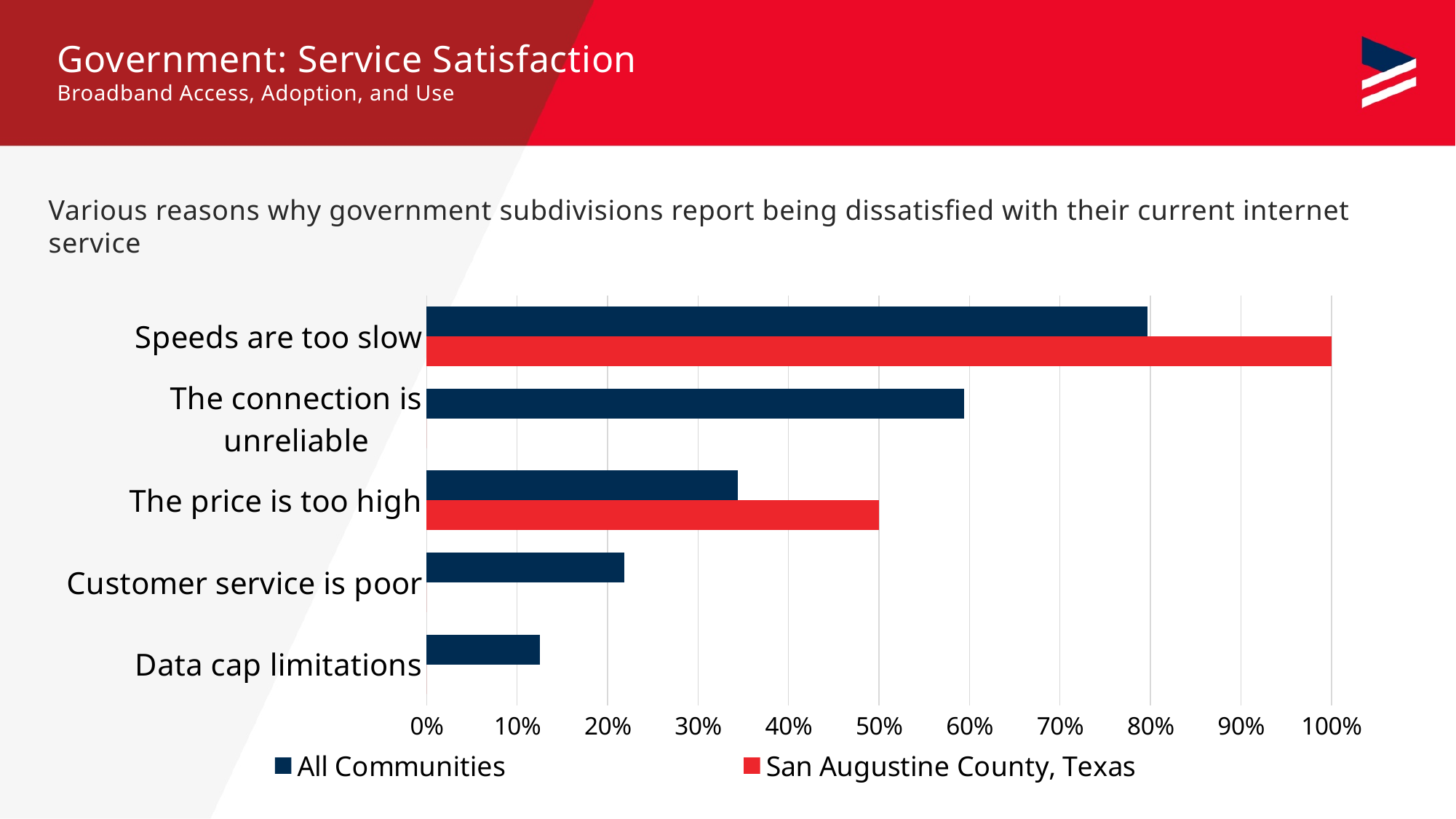
Is the All Communities value for 'Customer service is poor' greater or less than 30%? less What is the value for San Augustine County, Texas for 'Speeds are too slow'? 100% For 'The price is too high', which is larger: All Communities or San Augustine County, Texas? San Augustine County, Texas What is the value for San Augustine County, Texas for 'The price is too high'? 50% Which colour represents San Augustine County, Texas in the legend? red Which reason has the lowest value for All Communities? Data cap limitations What kind of chart is shown on the slide? bar chart How many series does the legend list? 2 Is the All Communities value for 'The connection is unreliable' greater or less than 50%? greater How many reasons (categories) are shown on the chart? 5 Is the All Communities value for 'Data cap limitations' greater or less than 20%? less Which reason has the highest value for All Communities? Speeds are too slow